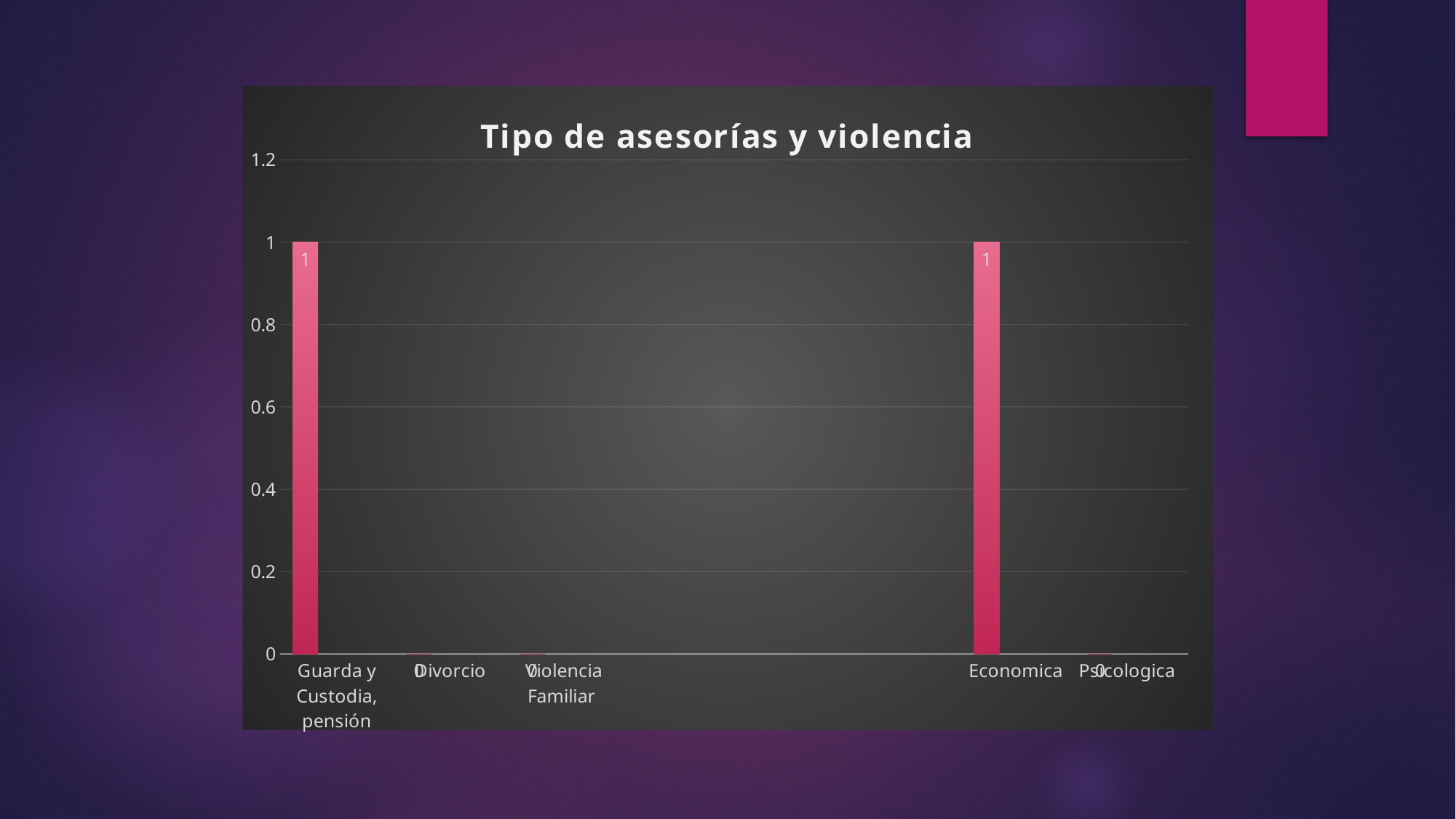
What is the title of the chart? Tipo de asesorías y violencia What is the difference between the value for Economica and the value for Violencia Familiar? 1 What is the value for Economica? 1 What is the value for Guarda y Custodia, pensión? 1 What is the highest value shown on the vertical axis? 1.2 What is the value for Divorcio? 0 Is the value for Guarda y Custodia, pensión greater or less than 0.8? greater What kind of chart is shown on the slide? bar chart What is the value for Violencia Familiar? 0 Which is larger, the value for Economica or the value for Psicologica? Economica What is the value for Psicologica? 0 Which is larger, the value for Guarda y Custodia, pensión or the value for Divorcio? Guarda y Custodia, pensión